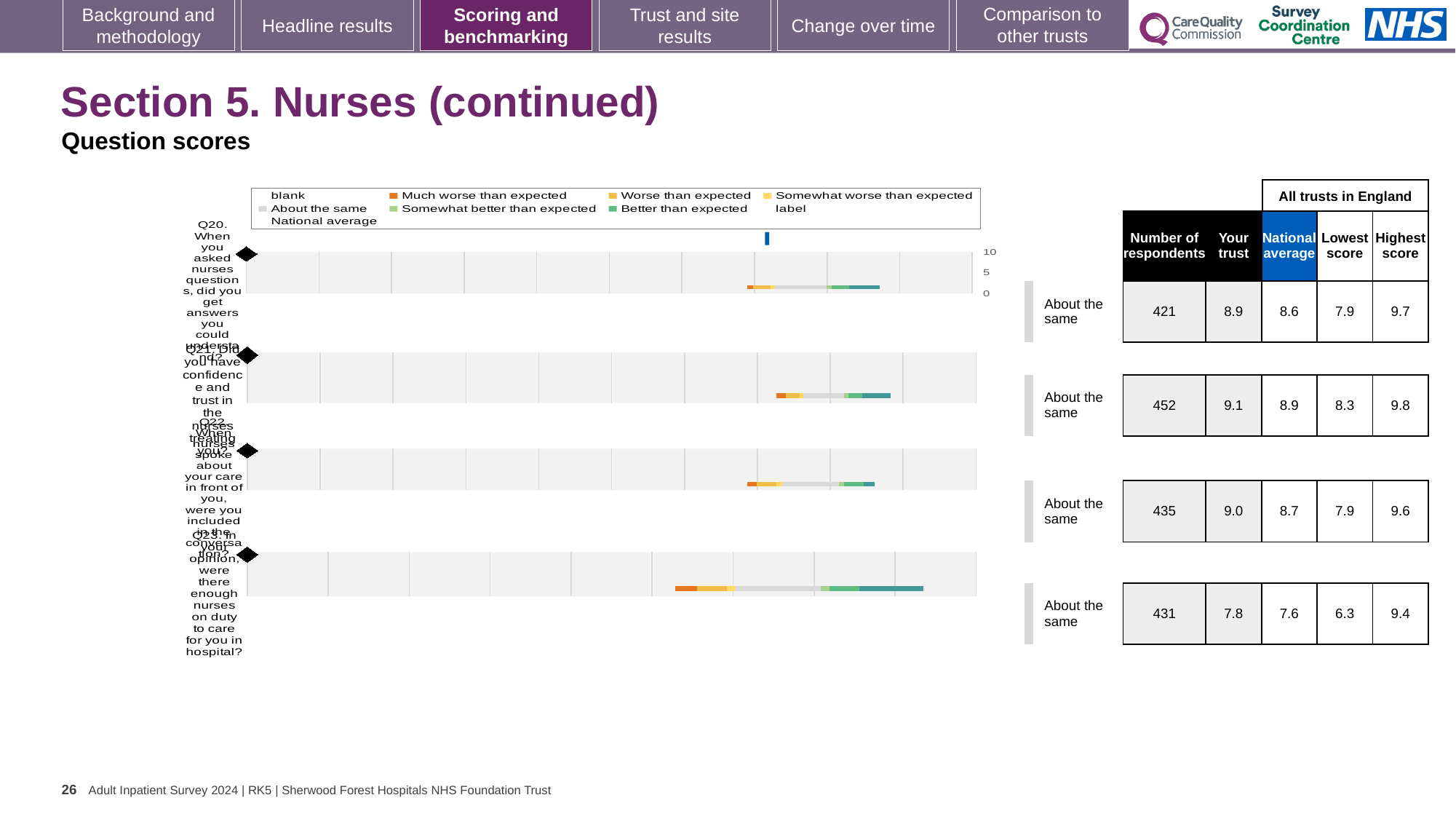
Is the trust's score for Q23 greater or less than 5 on the chart axis? greater How many respondents answered Q22? 435 For Q21, what is the difference between the highest score and the lowest score across all trusts in England? 1.5 What kind of chart is used to show the question scores on this slide? bar chart How many questions (Q20 to Q23) have a chart on this slide? 4 Which question has the lowest 'Your trust' score? Q23 Which question has the highest 'Your trust' score? Q21 For Q22, which is larger: the 'Your trust' score or the national average? Your trust What benchmark category is shown for Q23? About the same What is the 'Your trust' score for Q20 (When you asked nurses questions, did you get answers you could understand)? 8.9 What colour represents 'Much worse than expected' in the chart legend? orange What is the national average score for Q23 (were there enough nurses on duty to care for you in hospital)? 7.6